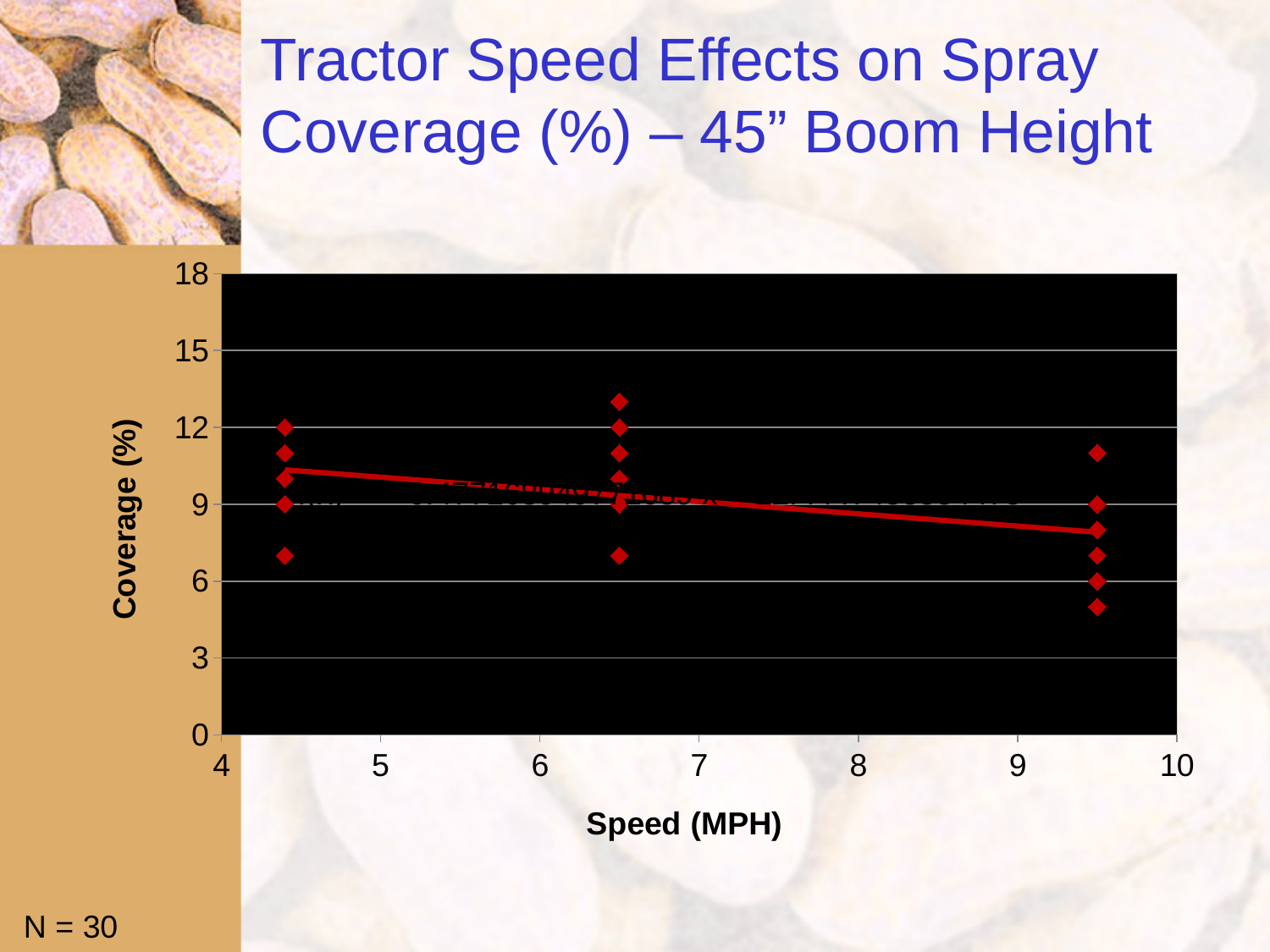
Which speed group contains the single highest plotted coverage value: the lowest-speed, middle, or highest-speed group? middle As tractor speed increases along the x axis, does the trend line for coverage rise or fall? fall What is the title of the x axis? Speed (MPH) At its left end (near 4.4 MPH), is the trend line greater or less than 9? greater At its right end (near 9.5 MPH), is the trend line greater or less than 9? less Is the highest coverage value plotted for the middle speed group (near 6.5 MPH) greater or less than 12? greater What kind of chart is shown on the slide? scatter chart Which speed group contains the single lowest plotted coverage value: the lowest-speed, middle, or highest-speed group? highest-speed What is the title of the y axis? Coverage (%) How many distinct speed settings have data points plotted? 3